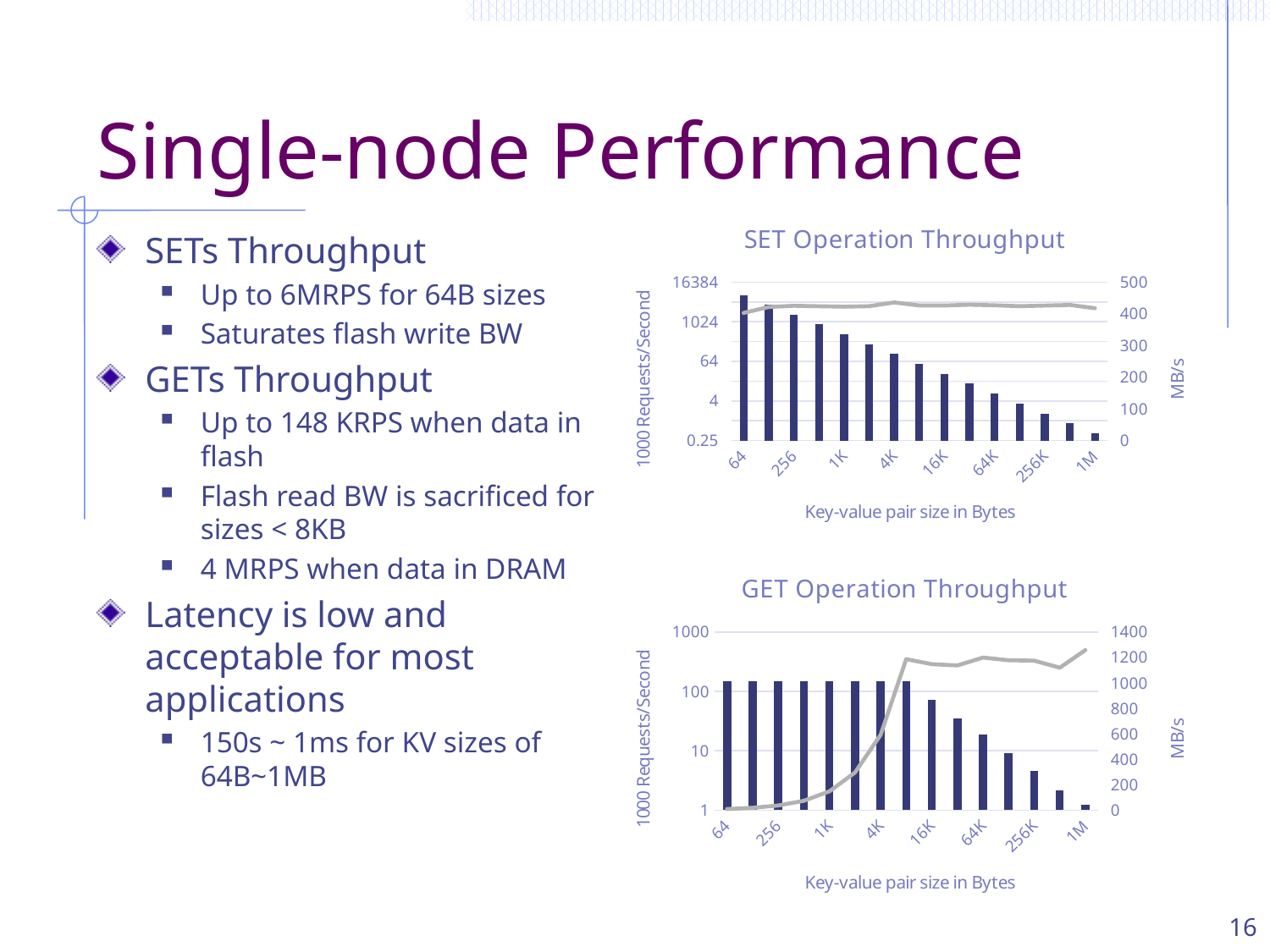
In the SET Operation Throughput chart, is the bar for 1M greater or less than 4 thousand requests/second? less In the SET Operation Throughput chart, which key-value pair size has the lowest bar? 1M What is the x-axis title of the GET Operation Throughput chart? Key-value pair size in Bytes In the GET Operation Throughput chart, does the MB/s line rise or fall as the key-value pair size increases? rise In the GET Operation Throughput chart, which key-value pair size has the lowest bar? 1M What kind of chart is the SET Operation Throughput chart? bar chart (with a line series) In the SET Operation Throughput chart, is the bar for 64 bytes greater or less than 1024 thousand requests/second? greater In the SET Operation Throughput chart, which key-value pair size has the highest bar? 64 In the GET Operation Throughput chart, which bar is taller, 256 or 256K? 256 In the GET Operation Throughput chart, is the bar for 1M greater or less than 10 thousand requests/second? less In the SET Operation Throughput chart, do the bars rise or fall as the key-value pair size increases? fall